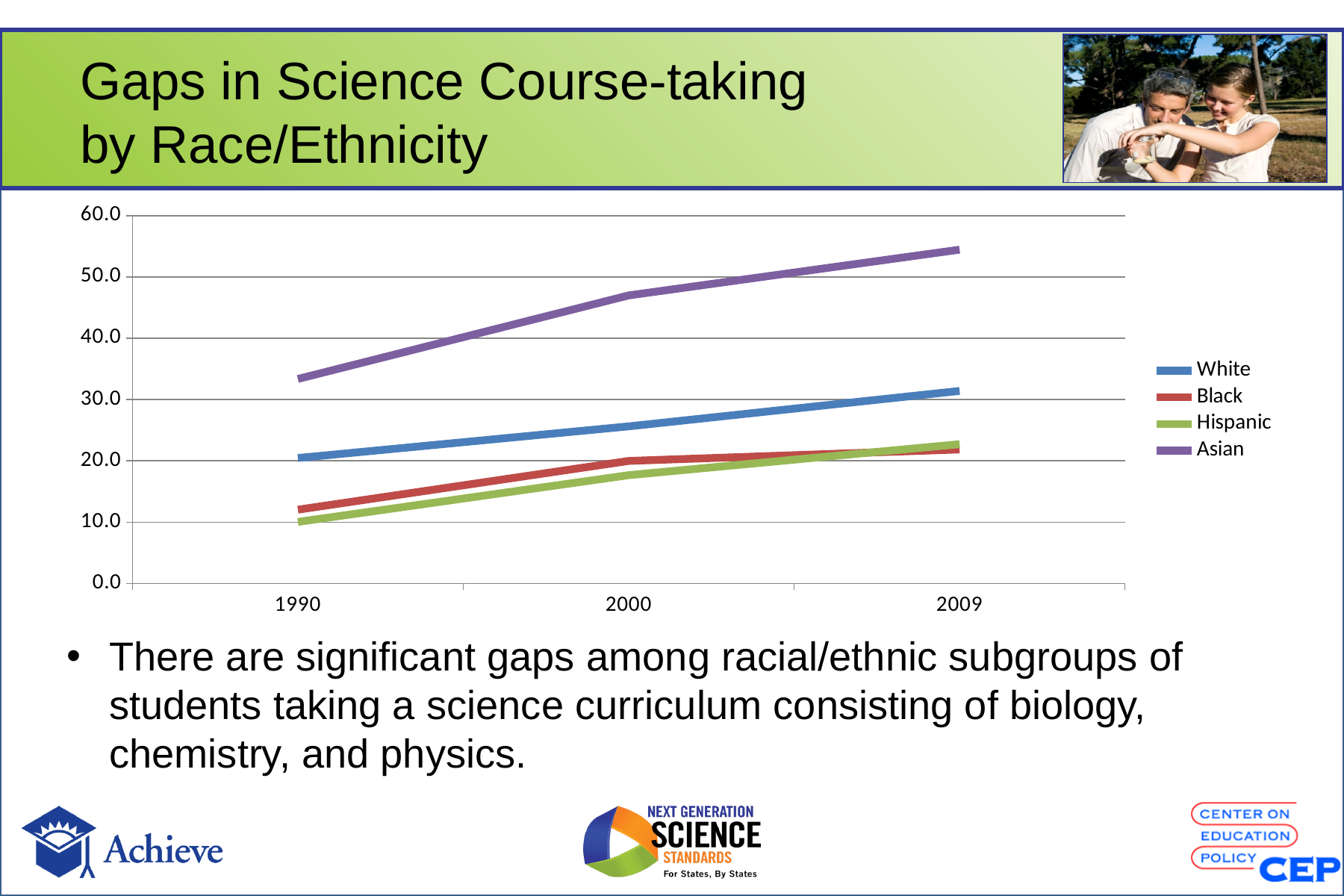
Is the value for Hispanic in 1990 greater or less than 20? less What kind of chart is shown on the slide? line chart Is the value for White in 2000 greater or less than 20? greater Is the value for Asian in 2009 greater or less than 50? greater Does the Asian line rise or fall from 1990 to 2009? rise How many series does the chart's legend list? 4 How many years are shown along the x axis of the chart? 3 What colour is the line for Asian in the chart? purple Which group has the highest value in 2009? Asian Which group has the lowest value in 1990? Hispanic In 1990, which is larger: the value for Black or the value for Hispanic? Black